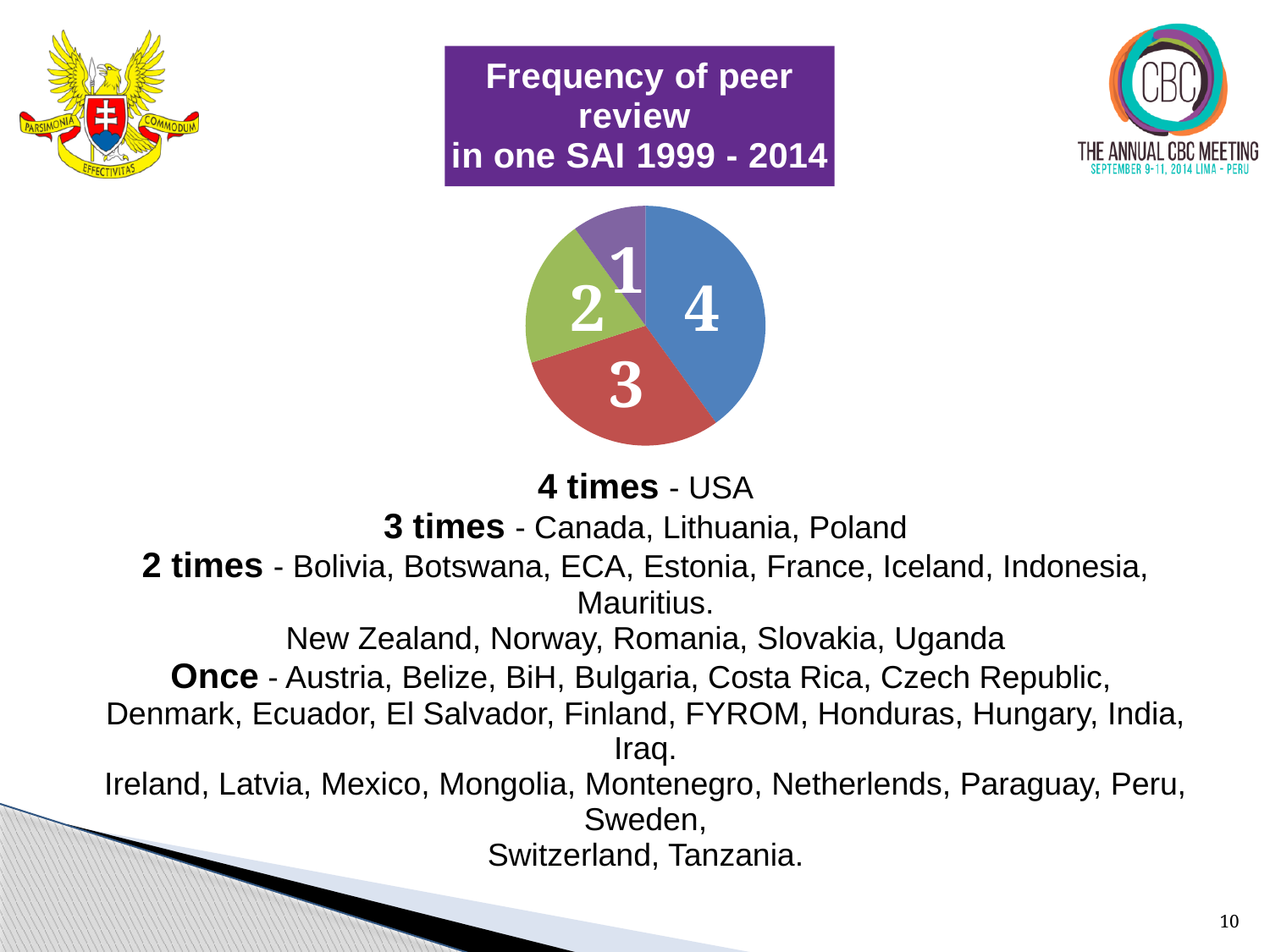
What colour is the slice labelled 4 in the pie chart? blue Which slice is larger, the one labelled 4 or the one labelled 3? 4 How many slices does the pie chart have? 4 Which label is on the smallest slice of the pie chart? 1 Which slice is larger, the one labelled 3 or the one labelled 2? 3 Which label is on the largest slice of the pie chart? 4 What is the title of the chart on the slide? Frequency of peer review in one SAI 1999 - 2014 Which slice is larger, the one labelled 2 or the one labelled 1? 2 What kind of chart is shown on the slide? pie chart